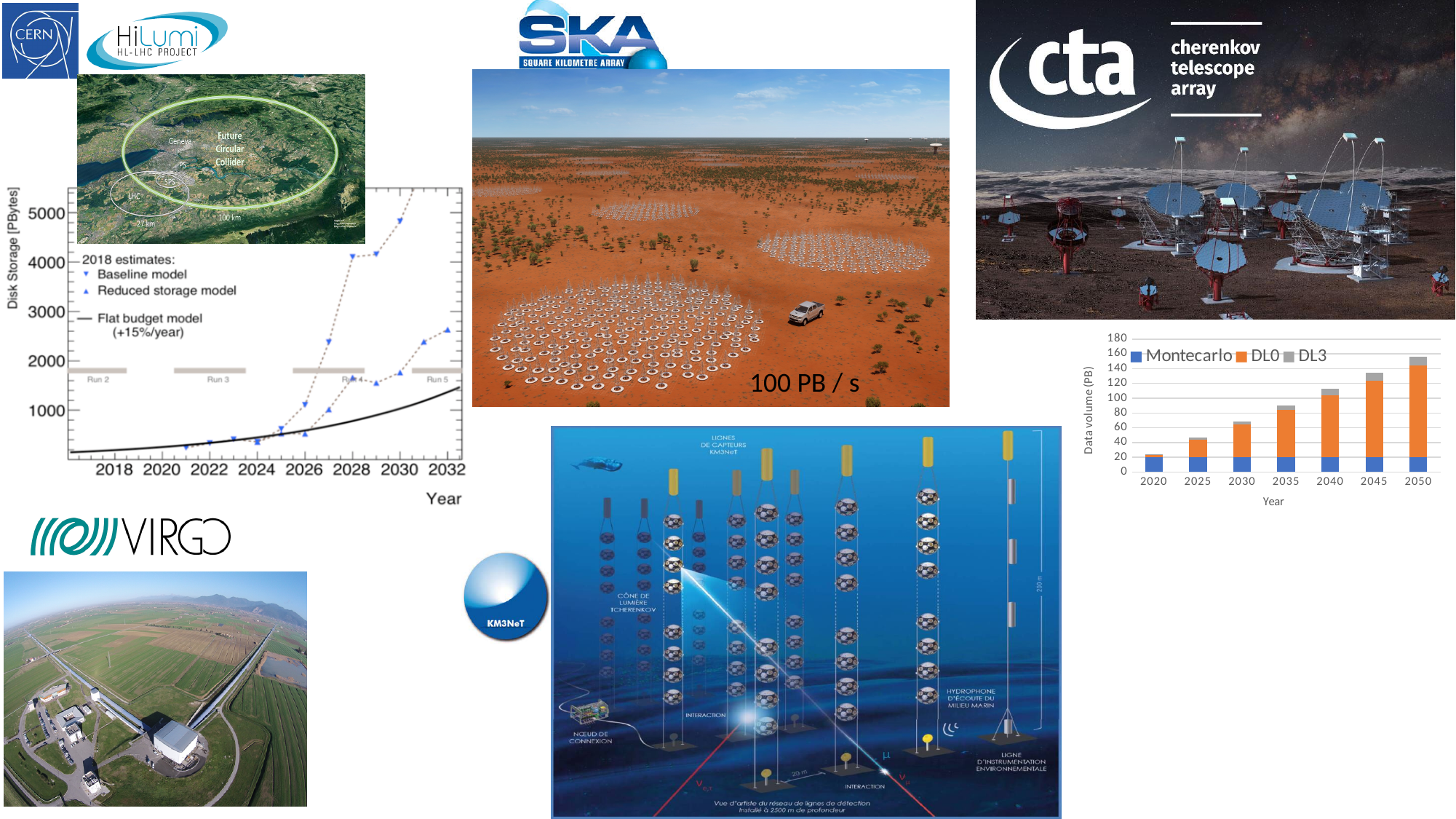
In the data volume chart on the right, is the total data volume for 2020 greater or less than 40? less In the data volume chart on the right, how many years are shown on the x axis? 7 In the data volume chart on the right, which year has the lowest total data volume? 2020 In the data volume chart on the right, does the total data volume rise or fall from 2020 to 2050? rise In the data volume chart on the right, which year has the highest total data volume? 2050 In the disk storage chart on the left, how many models does the legend list? 3 In the data volume chart on the right, which series is shown in orange? DL0 In the data volume chart on the right, how many series does the legend list? 3 In the disk storage chart on the left, is the Baseline model value in 2028 greater or less than 4000? greater In the data volume chart on the right, is the total data volume for 2050 greater or less than 140? greater In the disk storage chart on the left, which is higher in 2030: the Baseline model or the Reduced storage model? Baseline model What kind of chart is the chart on the right of the slide showing data volume in PB by year? Stacked bar chart